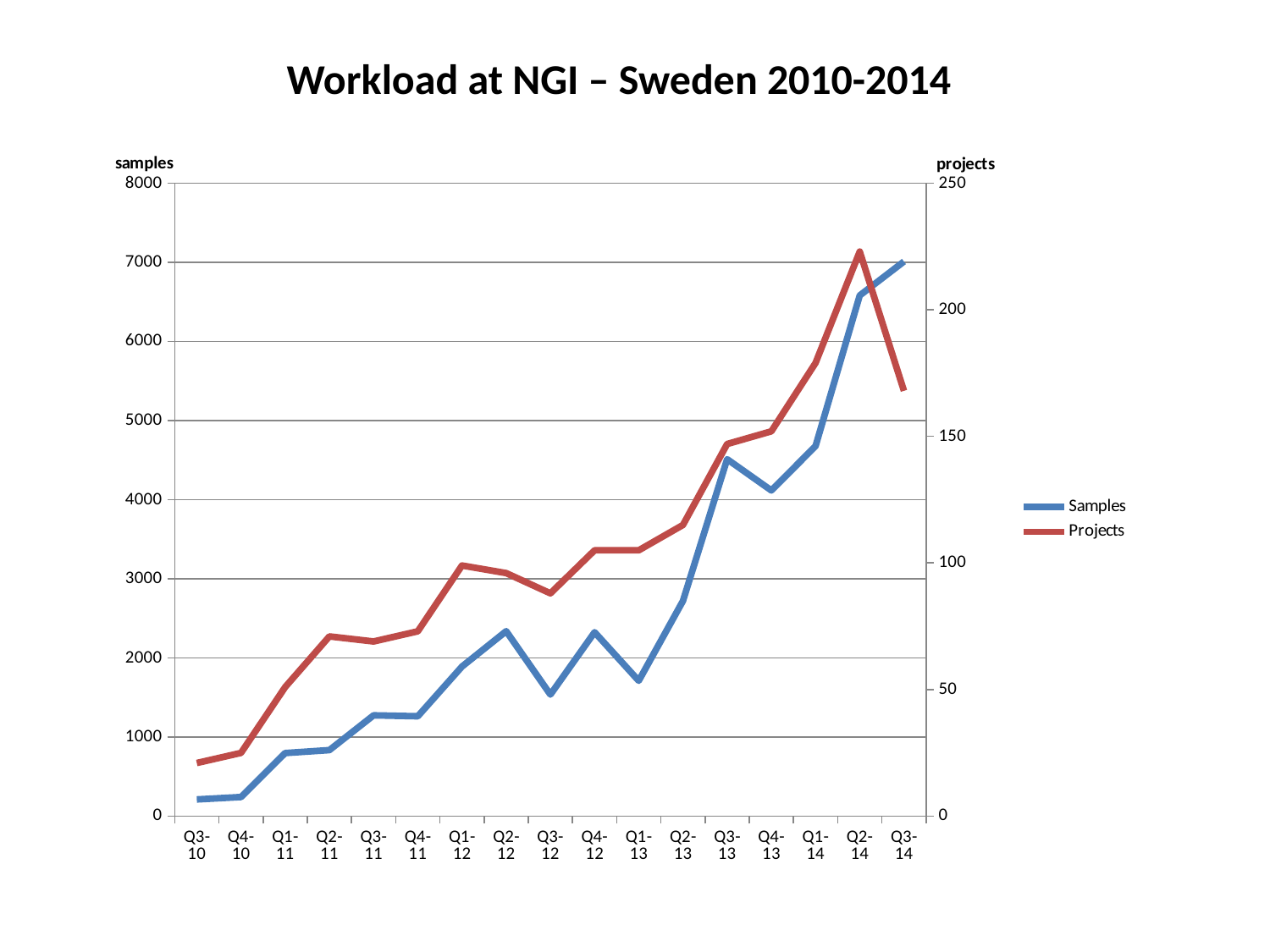
Is the value for Projects at Q3-10 greater or less than 50? less How many series does the legend list? 2 Do the Projects values rise or fall from Q2-14 to Q3-14? fall Is the value for Samples at Q2-14 greater or less than 6000? greater Is the value for Projects at Q2-14 greater or less than 200? greater Which is larger for Samples: the value at Q2-12 or the value at Q3-12? Q2-12 Which quarter has the highest value for Projects? Q2-14 How many quarters are plotted along the x axis? 17 Which quarter has the highest value for Samples? Q3-14 What kind of chart is shown on the slide? line chart What is the label on the right-hand vertical axis? projects